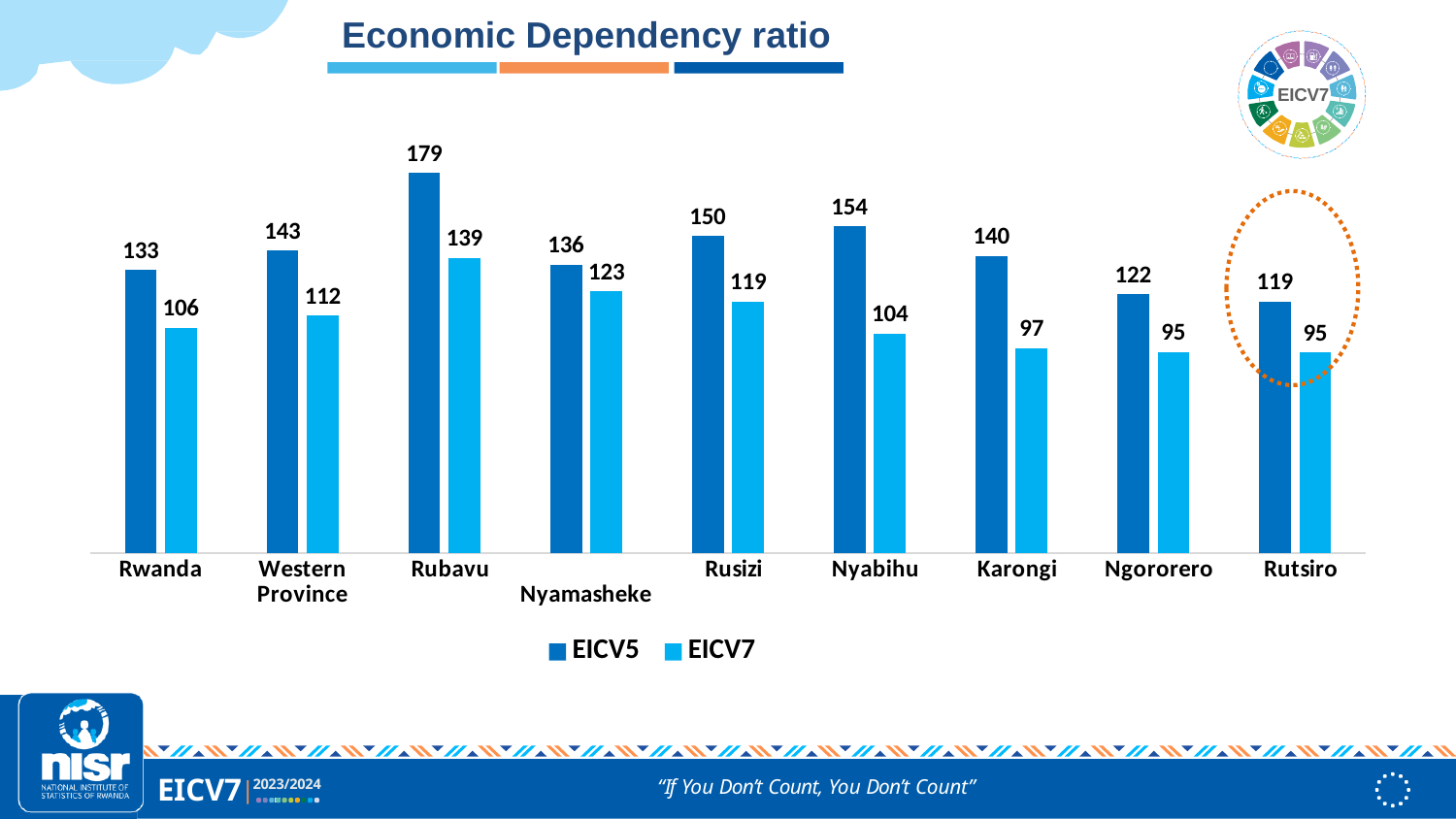
What kind of chart is shown on the slide? Bar chart Which category has the highest EICV5 value? Rubavu Which category has the lowest EICV5 value? Rutsiro Which is larger, the EICV7 value for Nyamasheke or the EICV7 value for Rusizi? Nyamasheke How many series does the legend list? 2 What is the EICV7 value for Karongi? 97 How many categories are shown on the x axis? 9 What is the EICV7 value for Rubavu? 139 What is the title of the chart? Economic Dependency ratio What is the difference between the EICV5 and EICV7 values for Rwanda? 27 What is the difference between the EICV5 values for Rubavu and Rusizi? 29 What is the EICV5 value for Nyabihu? 154